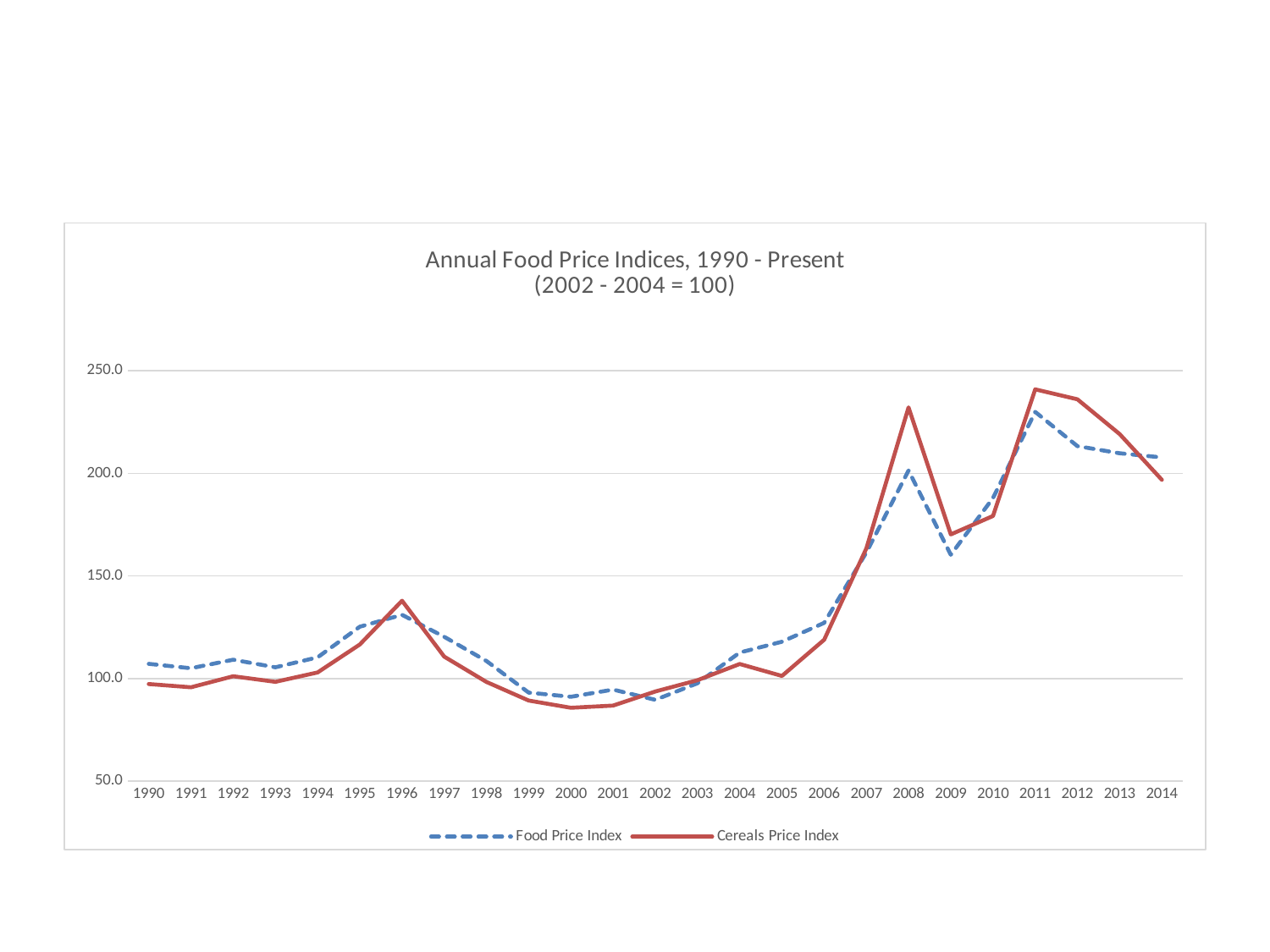
How many series does the legend list? 2 In which year is the Cereals Price Index at its lowest? 2000 How many years are plotted along the x axis? 25 Is the Cereals Price Index value for 2000 greater or less than 100? less Is the Food Price Index value for 2009 greater or less than 150? greater In 2011, which series has the higher value, Food Price Index or Cereals Price Index? Cereals Price Index What is the title of the chart? Annual Food Price Indices, 1990 - Present (2002 - 2004 = 100) Is the Cereals Price Index value for 2008 greater or less than 200? greater In which year does the Cereals Price Index reach its highest value? 2011 What kind of chart is shown on the slide? Line chart In 1990, which series has the higher value, Food Price Index or Cereals Price Index? Food Price Index Does the Cereals Price Index rise or fall from 2011 to 2014? Fall